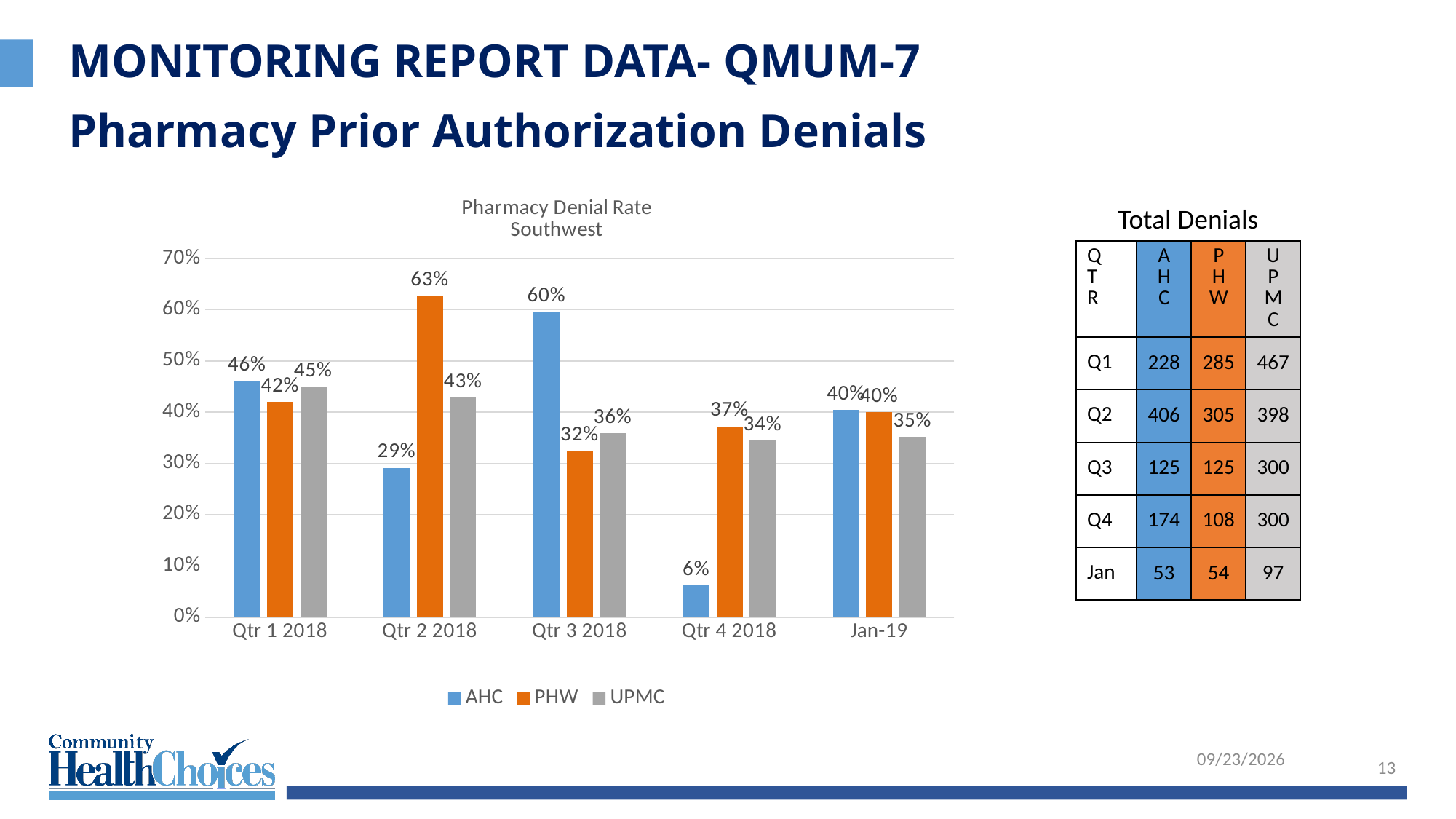
What is the title of the chart? Pharmacy Denial Rate Southwest What is the pharmacy denial rate for PHW in Qtr 2 2018? 63% What is the difference between the PHW and AHC denial rates in Qtr 2 2018? 34% What kind of chart is shown on the slide? Bar chart Which period has the lowest PHW denial rate? Qtr 3 2018 Which quarter has the highest AHC denial rate? Qtr 3 2018 Does the UPMC denial rate rise or fall from Qtr 1 2018 to Jan-19? Fall In Qtr 3 2018, which is larger, the AHC denial rate or the UPMC denial rate? AHC What is the pharmacy denial rate for AHC in Qtr 4 2018? 6% How many periods are shown on the x axis of the chart? 5 What is the pharmacy denial rate for UPMC in Qtr 1 2018? 45% How many series does the chart legend list? 3